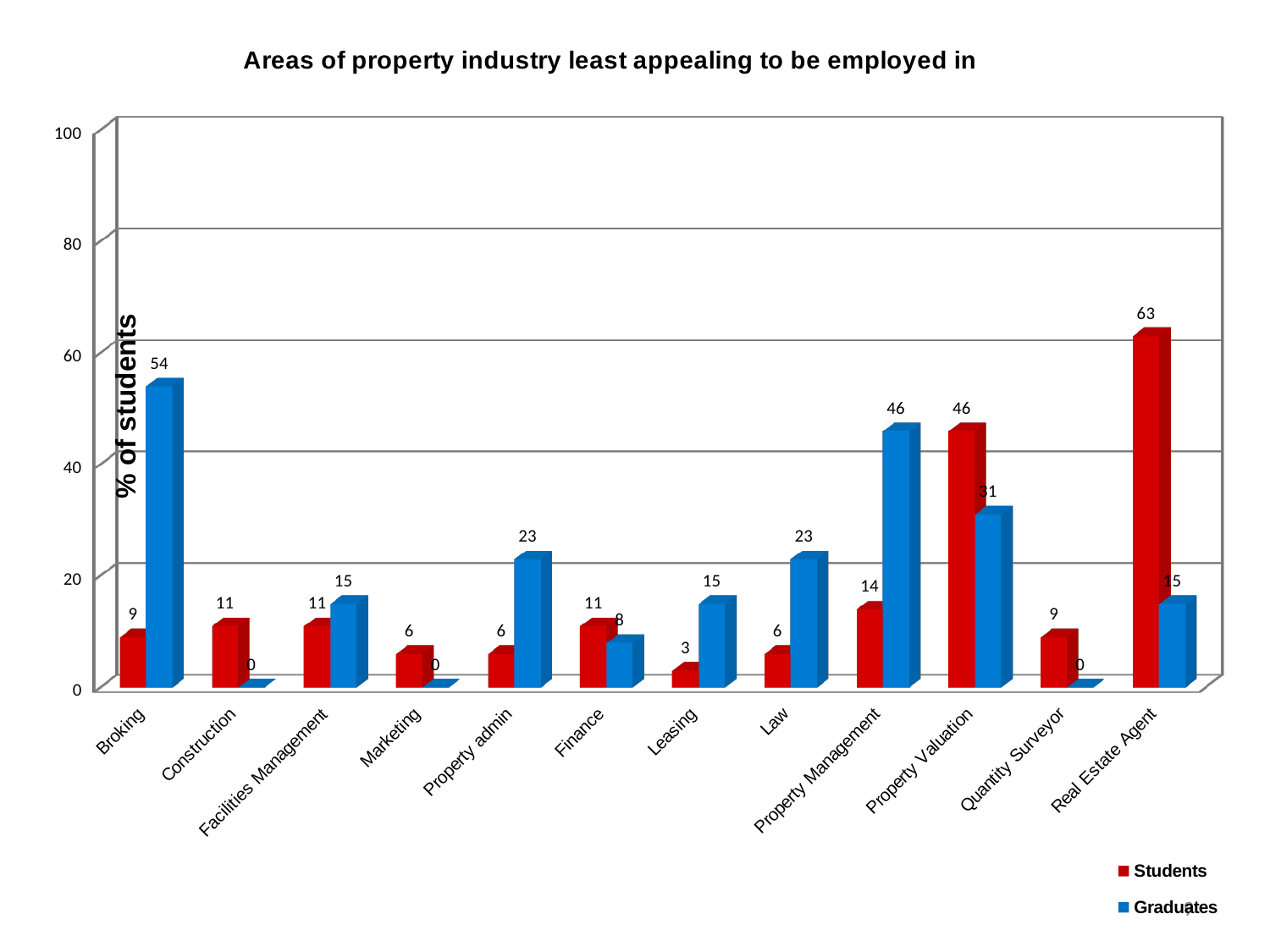
How many series does the legend list? 2 How many categories are shown on the x axis? 12 Which category has the highest Graduates value? Broking What is the Students value for Real Estate Agent? 63 What is the Graduates value for Property admin? 23 What is the label of the vertical axis? % of students What kind of chart is shown on the slide? Bar chart Which category has the lowest Students value? Leasing For Property Valuation, which series has the larger value, Students or Graduates? Students What is the Graduates value for Broking? 54 Which category has the highest Students value? Real Estate Agent What is the difference between the Graduates and Students values for Property Management? 32